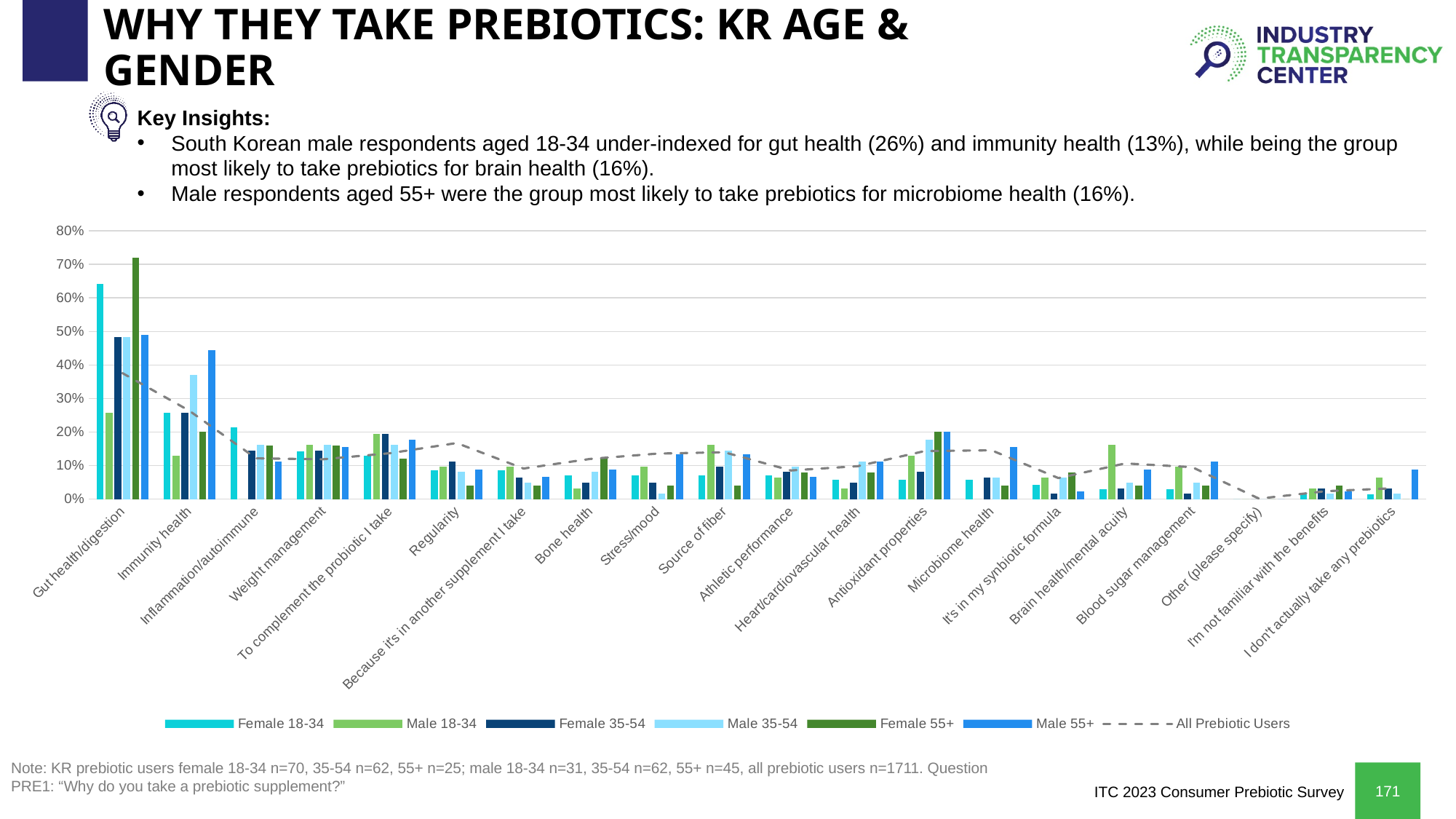
What kind of chart is shown on the slide? combination bar and line chart Does the dashed All Prebiotic Users line generally rise or fall from left to right across the categories? fall How many categories are shown along the x axis? 20 How many series does the legend list? 7 Which series is plotted as a dashed line rather than bars? All Prebiotic Users Which category has the tallest bar in the chart? Gut health/digestion Is the Male 55+ value for Immunity health greater or less than 40%? greater Within the Gut health/digestion category, which series has the highest bar? Female 55+ Is the Female 55+ value for Gut health/digestion greater or less than 60%? greater Is the Male 18-34 value for Immunity health greater or less than 20%? less For Immunity health, which is larger: the Male 55+ value or the Female 18-34 value? Male 55+